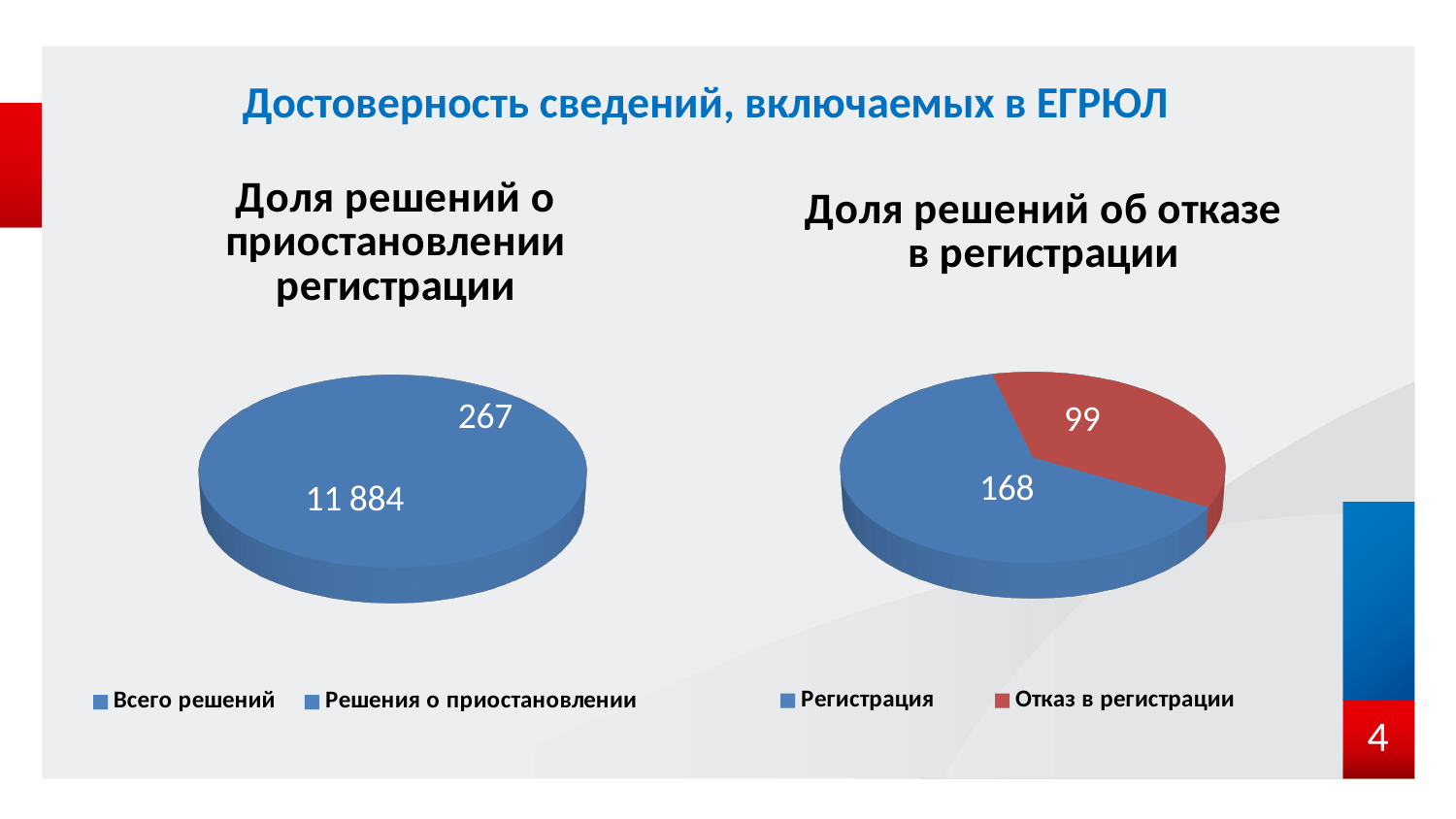
In the right chart "Доля решений об отказе в регистрации", what is the total of "Регистрация" and "Отказ в регистрации"? 267 In the left chart "Доля решений о приостановлении регистрации", what is the value for "Решения о приостановлении"? 267 In the right chart "Доля решений об отказе в регистрации", what is the value for "Отказ в регистрации"? 99 In the left chart "Доля решений о приостановлении регистрации", what is the value for "Всего решений"? 11 884 In the right chart "Доля решений об отказе в регистрации", what is the difference between "Регистрация" and "Отказ в регистрации"? 69 In the right chart "Доля решений об отказе в регистрации", what colour is the slice for "Отказ в регистрации"? red In the right chart "Доля решений об отказе в регистрации", which category has the smaller value? Отказ в регистрации What type of chart is used on the left side of the slide, titled "Доля решений о приостановлении регистрации"? pie chart How many entries does the legend of the right chart "Доля решений об отказе в регистрации" list? 2 How many slices does the left chart "Доля решений о приостановлении регистрации" have? 2 In the right chart "Доля решений об отказе в регистрации", which category has the larger value? Регистрация In the right chart "Доля решений об отказе в регистрации", what is the value for "Регистрация"? 168